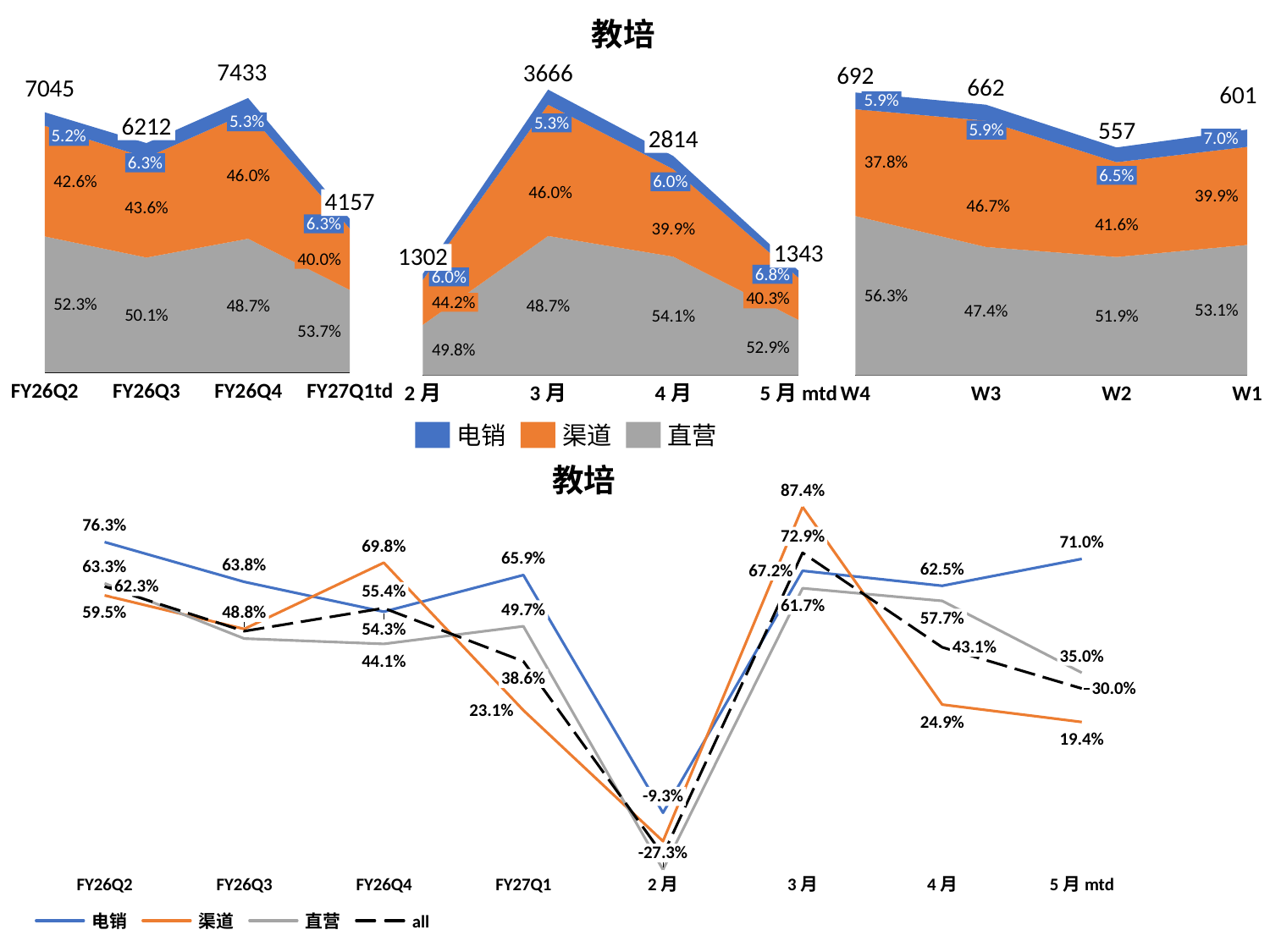
In the top-middle chart (2月 to 5月 mtd), what is the total value shown for 3月? 3666 In the bottom line chart, what is the 渠道 value for 3月? 87.4% In the bottom line chart, what is the 电销 value for 5月 mtd? 71.0% In the bottom line chart, which series is higher at 4月: 电销 or 渠道? 电销 In the top-left chart (FY26Q2 to FY27Q1td), what is the total value shown for FY26Q4? 7433 In the top-middle chart (2月 to 5月 mtd), what is the difference between the totals for 3月 and 4月? 852 How many series does the legend of the top row of charts list? 3 In the top-right chart (W4 to W1), what is the 电销 share for W1? 7.0% In the top-left chart (FY26Q2 to FY27Q1td), which period has the lowest total value? FY27Q1td In the top-middle chart (2月 to 5月 mtd), what is the 渠道 share for 4月? 39.9% In the top-right chart (W4 to W1), which week has the highest total value? W4 In the top-left chart (FY26Q2 to FY27Q1td), what is the 直营 share for FY26Q2? 52.3%